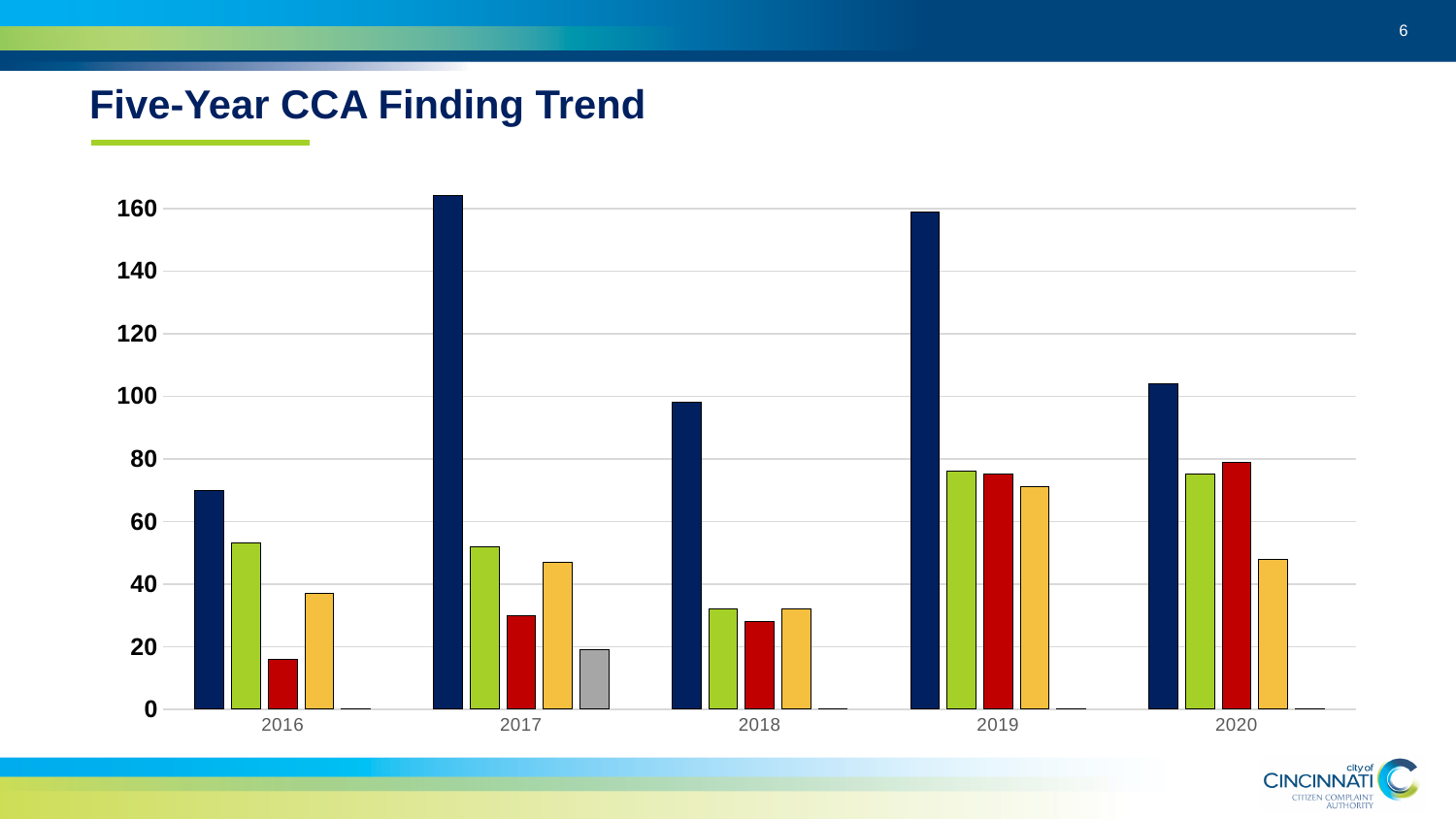
In which year is the dark blue bar the shortest? 2016 Does the dark blue bar rise or fall from 2016 to 2017? rise What is the title of the chart? Five-Year CCA Finding Trend In which year is the orange bar the tallest? 2019 For 2020, which is taller: the dark blue bar or the red bar? the dark blue bar What kind of chart is shown on the slide? bar chart In which year is the green bar the shortest? 2018 In which year is the dark blue bar the tallest? 2017 Is the red bar for 2016 greater or less than 20? less How many years are shown along the x axis of the chart? 5 Is the dark blue bar for 2017 greater or less than 160? greater